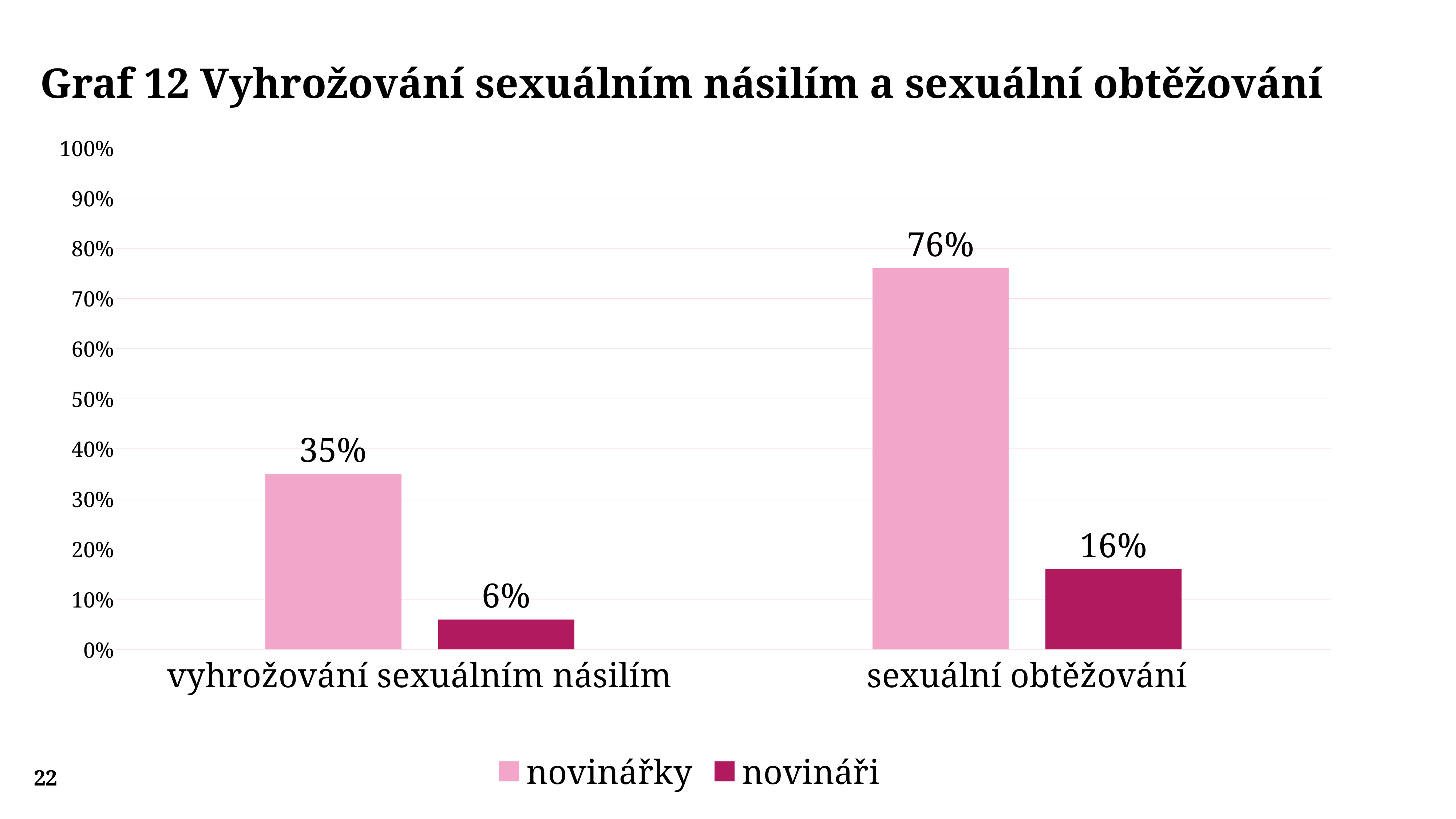
Which category has the lowest value for novináři? vyhrožování sexuálním násilím What is the value for novinářky in the category vyhrožování sexuálním násilím? 35% What is the value for novináři in the category vyhrožování sexuálním násilím? 6% What is the value for novináři in the category sexuální obtěžování? 16% How many series does the legend list? 2 What is the difference between the novinářky and novináři values for vyhrožování sexuálním násilím? 29% How many categories are shown on the x axis? 2 What kind of chart is shown on the slide? bar chart Which is larger: the novinářky value for vyhrožování sexuálním násilím or the novináři value for sexuální obtěžování? novinářky value for vyhrožování sexuálním násilím What is the difference between the novinářky and novináři values for sexuální obtěžování? 60% What is the value for novinářky in the category sexuální obtěžování? 76% Which category has the highest value for novinářky? sexuální obtěžování